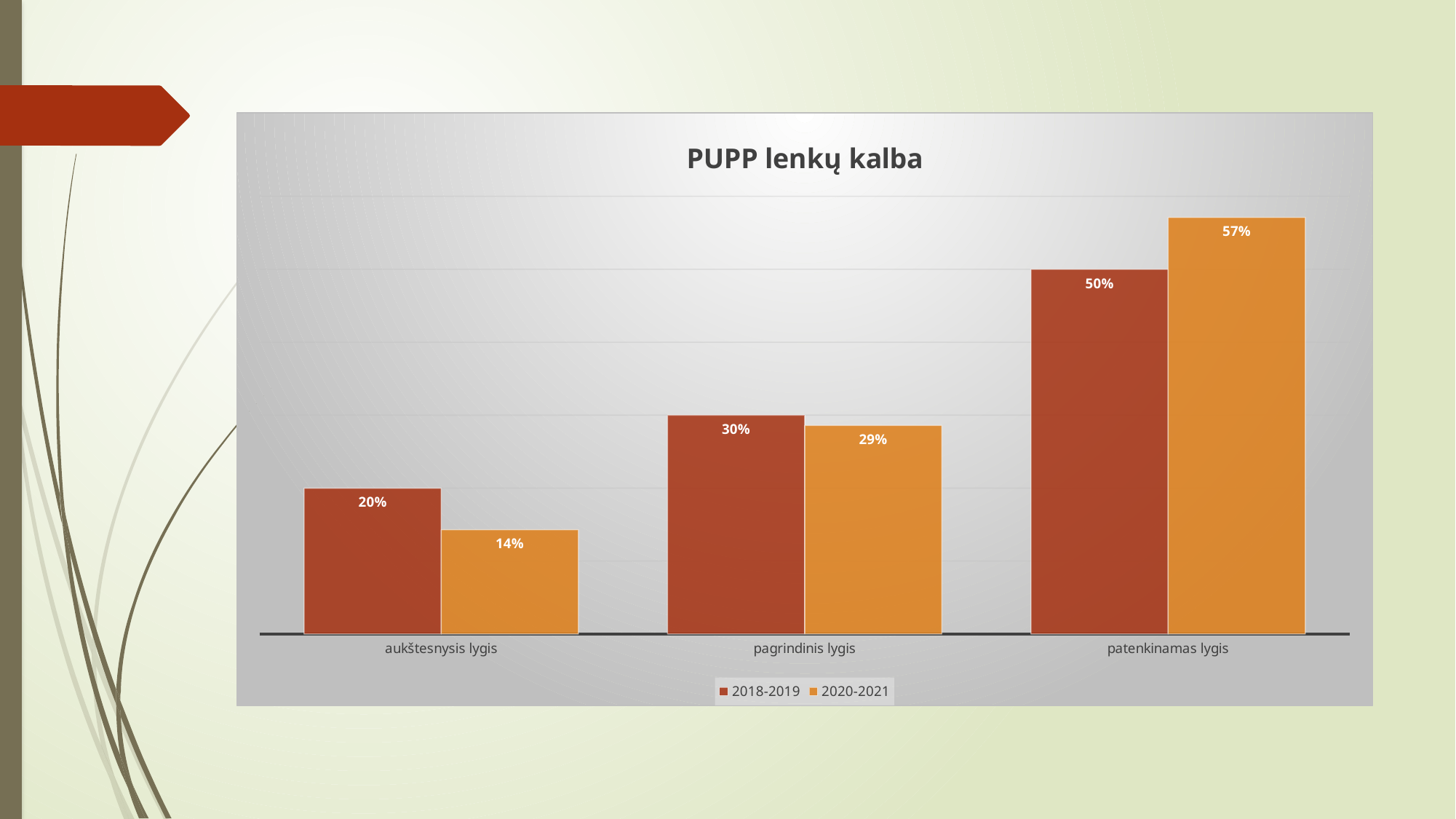
How many categories are shown on the x axis? 3 Which category has the lowest value for the 2020-2021 series? aukštesnysis lygis What is the difference between the 2020-2021 and 2018-2019 values for patenkinamas lygis? 7% What is the value for 2020-2021 in the patenkinamas lygis category? 57% Which category has the highest value for the 2018-2019 series? patenkinamas lygis What kind of chart is shown on the slide? bar chart What is the value for 2018-2019 in the aukštesnysis lygis category? 20% What is the title of the chart? PUPP lenkų kalba What is the value for 2020-2021 in the pagrindinis lygis category? 29% In the aukštesnysis lygis category, which series has the larger value, 2018-2019 or 2020-2021? 2018-2019 What is the difference between the 2018-2019 and 2020-2021 values for aukštesnysis lygis? 6% How many series does the legend list? 2